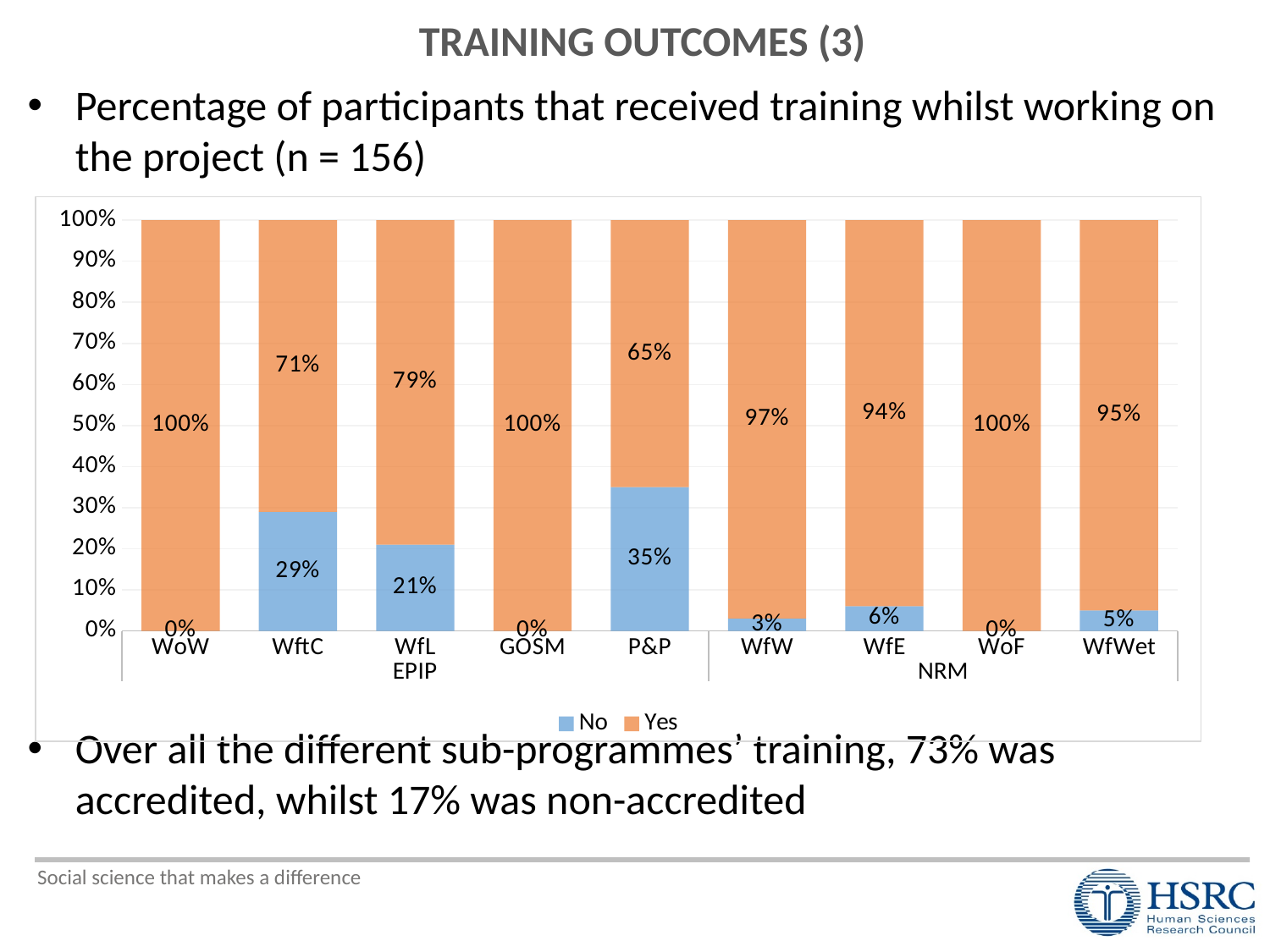
How many categories are shown on the x axis? 9 How many series does the legend list? 2 Which has a larger 'No' value, WfW or WfE? WfE What is the difference between the 'Yes' values for WfL and WftC? 8% What is the 'No' value for WftC? 29% Which colour represents the 'Yes' series? Orange What percentage of P&P participants received training (Yes)? 65% What is the 'No' value for WfWet? 5% What is the 'Yes' value for WfE? 94% What kind of chart is shown? Stacked bar chart Which category has the lowest 'Yes' percentage? P&P Which category has the highest 'No' percentage? P&P